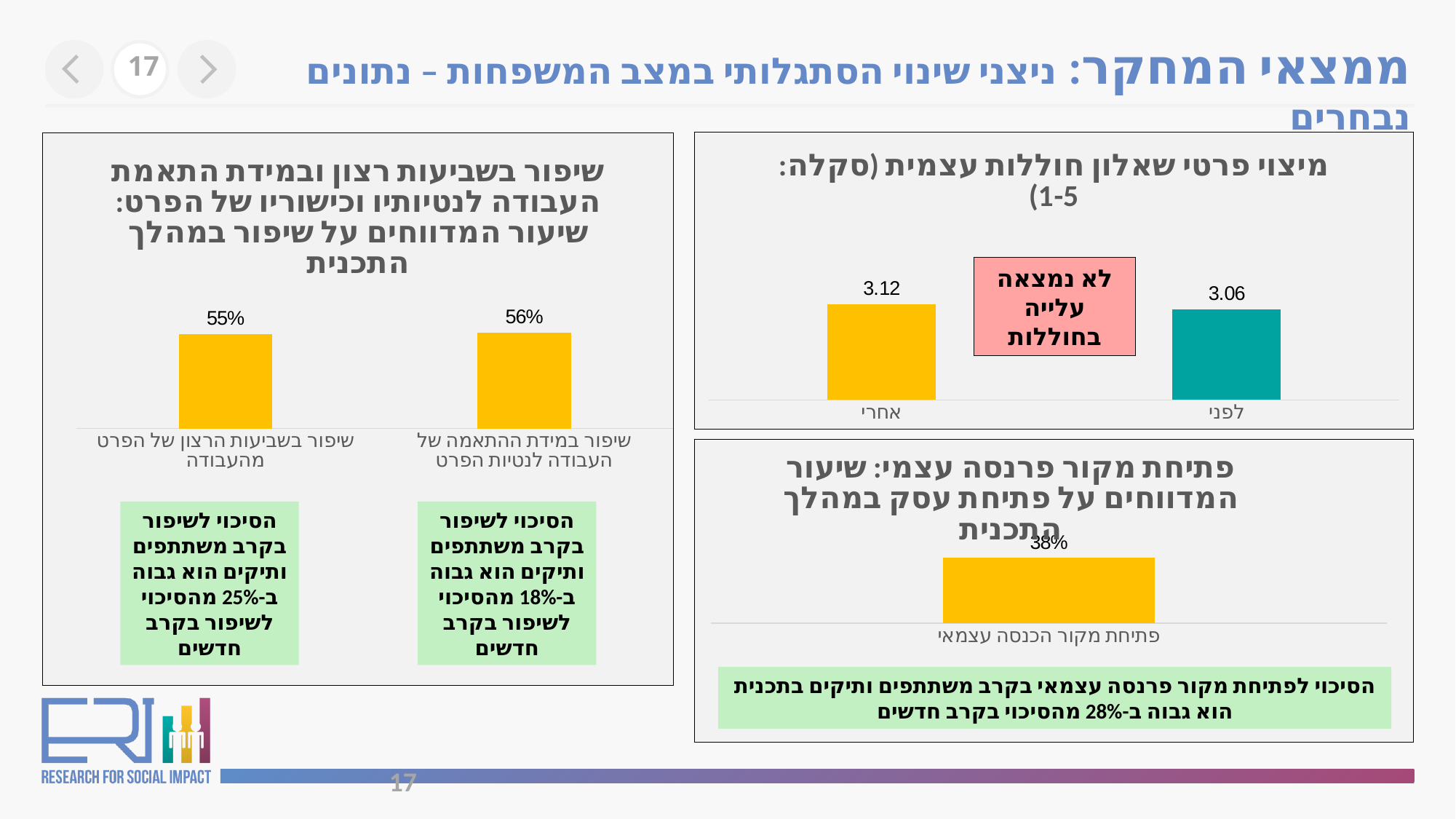
What kind of chart is the bottom-right chart (פתיחת מקור פרנסה עצמי)? bar chart In the top-right chart (מיצוי פרטי שאלון חוללות עצמית), what is the value for לפני? 3.06 In the top-right chart (מיצוי פרטי שאלון חוללות עצמית), what does the pink box say? לא נמצאה עלייה בחוללות In the left chart (שיפור בשביעות רצון ובמידת התאמת העבודה), what is the value for שיפור בשביעות הרצון של הפרט מהעבודה? 55% In the left chart (שיפור בשביעות רצון ובמידת התאמת העבודה), how many bars are plotted? 2 In the top-right chart (מיצוי פרטי שאלון חוללות עצמית), what scale is stated in the title? 1-5 In the bottom-right chart (פתיחת מקור פרנסה עצמי), what is the value for פתיחת מקור הכנסה עצמאי? 38% In the top-right chart (מיצוי פרטי שאלון חוללות עצמית), what is the difference between the אחרי and לפני values? 0.06 In the bottom-right chart (פתיחת מקור פרנסה עצמי), how many bars are plotted? 1 In the left chart (שיפור בשביעות רצון ובמידת התאמת העבודה), what is the value for שיפור במידת ההתאמה של העבודה לנטיות הפרט? 56% In the left chart (שיפור בשביעות רצון ובמידת התאמת העבודה), what is the difference between the two bar values? 1% In the top-right chart (מיצוי פרטי שאלון חוללות עצמית), what is the value for אחרי? 3.12